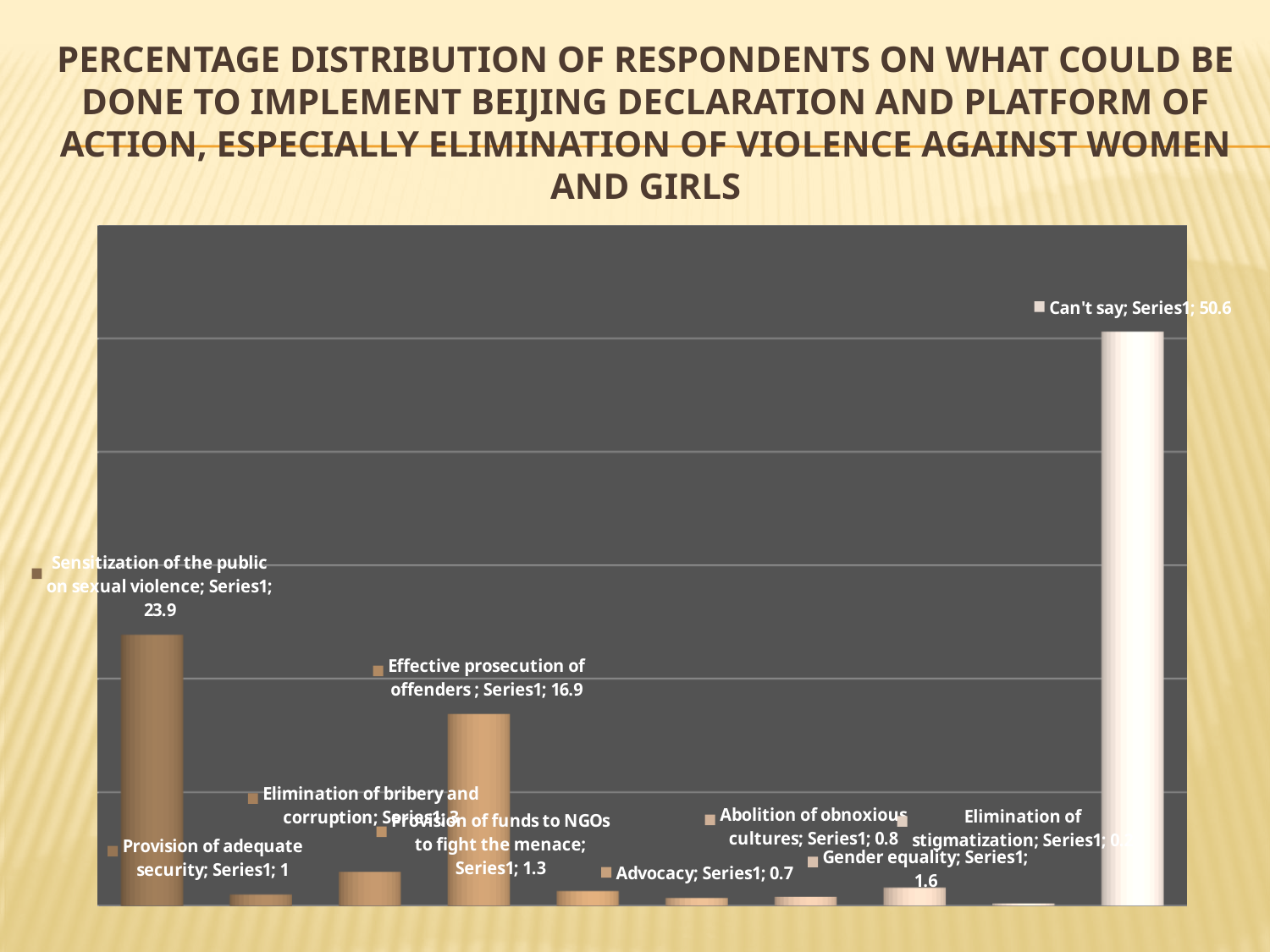
What is the value for "Can't say"? 50.6 Which is larger, the value for "Gender equality" or the value for "Provision of funds to NGOs to fight the menace"? Gender equality What kind of chart is shown on the slide? Bar chart What is the value for "Effective prosecution of offenders"? 16.9 Which category has the lowest value? Elimination of stigmatization What is the value for "Gender equality"? 1.6 What is the difference between the values for "Sensitization of the public on sexual violence" and "Effective prosecution of offenders"? 7 How many categories are plotted in the chart? 10 What is the value for "Sensitization of the public on sexual violence"? 23.9 What is the value for "Advocacy"? 0.7 What is the difference between the values for "Can't say" and "Sensitization of the public on sexual violence"? 26.7 Which category has the highest value? Can't say